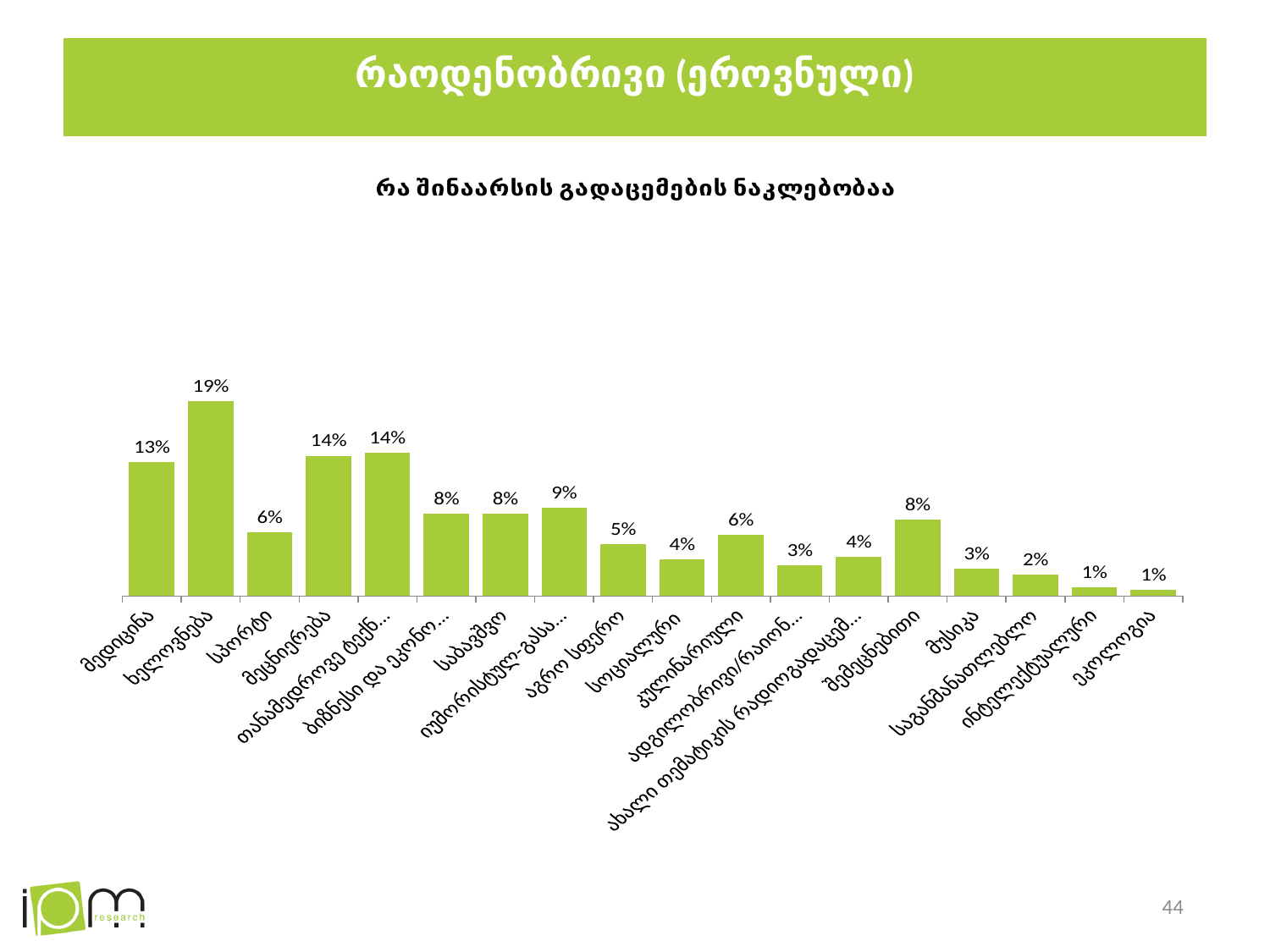
What is the value for ხელოვნება? 19% What is the title of the chart? რა შინაარსის გადაცემების ნაკლებობაა How many categories are shown in the chart? 18 Which is larger, the value for მუსიკა or the value for შემეცნებითი? შემეცნებითი Which category has the highest value? ხელოვნება What is the difference between the values for მეცნიერება and სპორტი? 8% What is the value for საგანმანათლებლო? 2% What kind of chart is shown on the slide? bar chart What is the value for შემეცნებითი? 8% What is the value for მედიცინა? 13% What is the difference between the values for ხელოვნება and მედიცინა? 6% Which is larger, the value for აგრო სფერო or the value for კულინარიული? კულინარიული